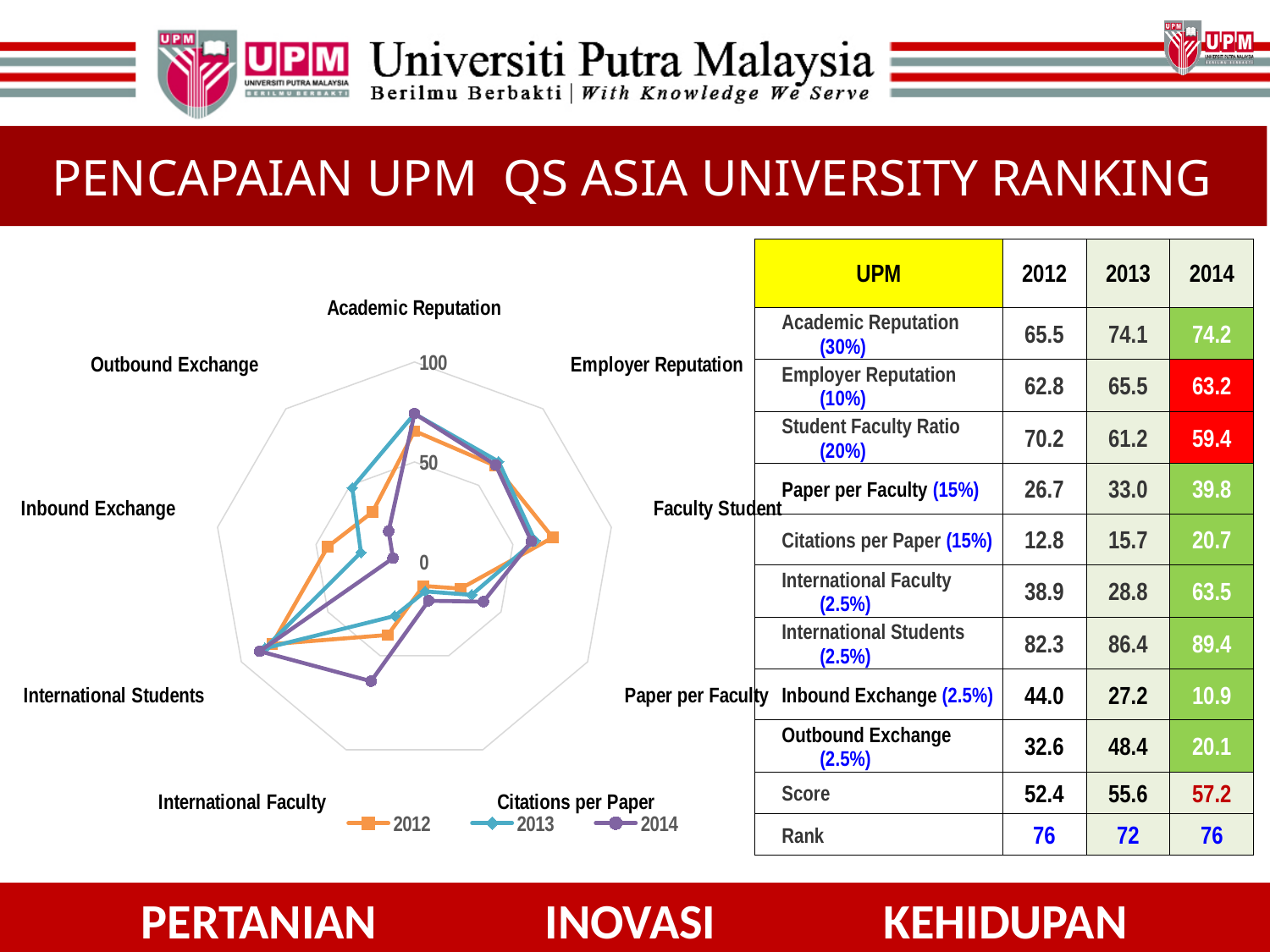
What is the value for International Students in 2013? 86.4 What are the legend entries of the radar chart? 2012, 2013, 2014 What is the value for Academic Reputation in 2014? 74.2 For Outbound Exchange, which year has the larger value, 2012 or 2013? 2013 Does the value for Paper per Faculty rise or fall from 2012 to 2014? rise What kind of chart is shown on the left of the slide? Radar chart Is the value for Citations per Paper in 2012 greater or less than 50? less How many series does the legend of the radar chart list? 3 Which category has the lowest value for the 2014 series? Inbound Exchange What is the difference between the International Faculty values for 2014 and 2013? 34.7 Which category has the highest value for the 2014 series? International Students How many categories (axes) does the radar chart have? 9